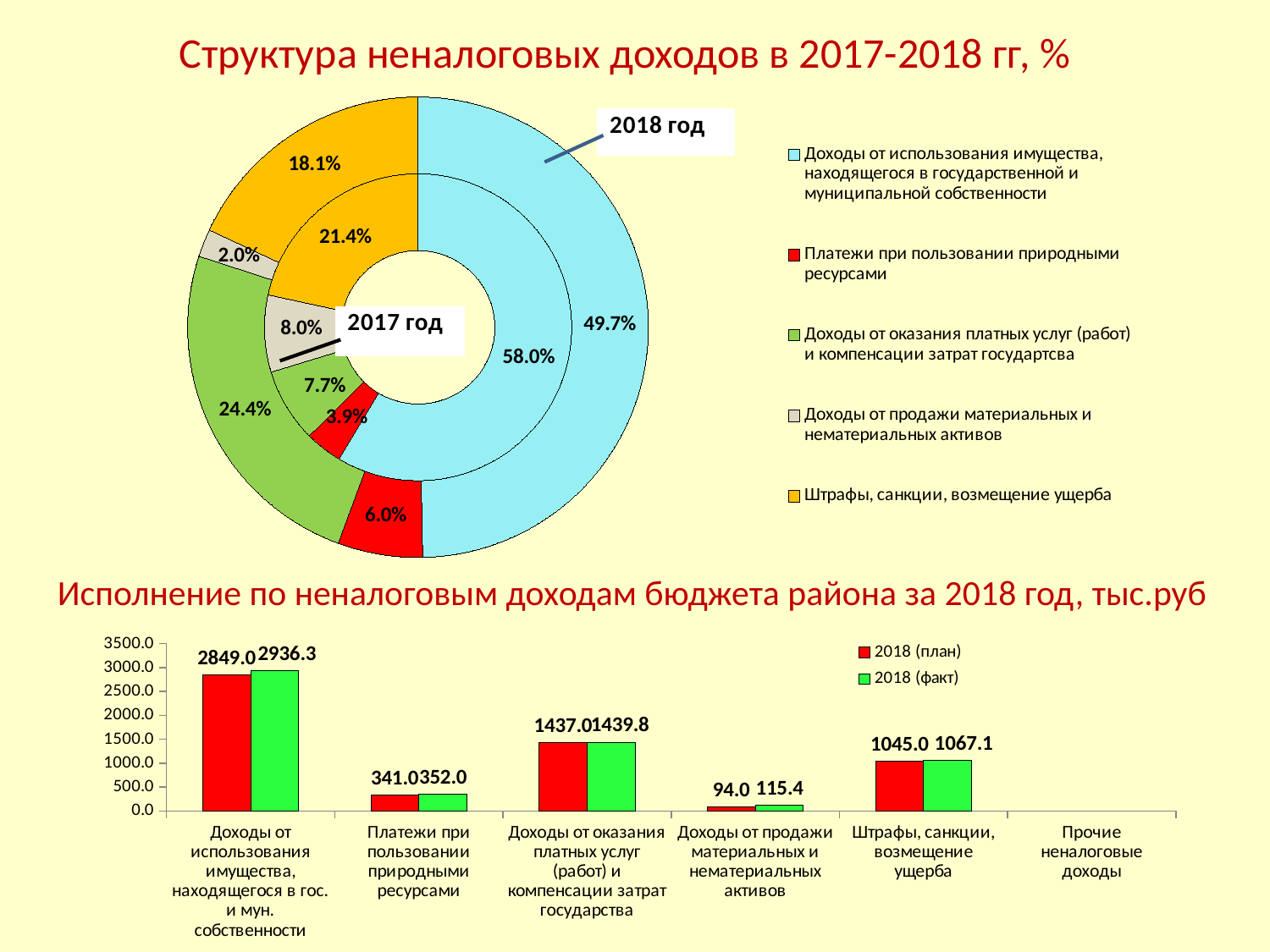
In the doughnut chart 'Структура неналоговых доходов в 2017-2018 гг, %', by how many percentage points did the share of 'Платежи при пользовании природными ресурсами' change from 2017 (3.9%) to 2018 (6.0%)? 2.1 percentage points In the bar chart 'Исполнение по неналоговым доходам бюджета района за 2018 год, тыс.руб', what is the 2018 (факт) value for 'Платежи при пользовании природными ресурсами'? 352.0 In the doughnut chart 'Структура неналоговых доходов в 2017-2018 гг, %', which category had the smallest share in 2018? Доходы от продажи материальных и нематериальных активов In the bar chart 'Исполнение по неналоговым доходам бюджета района за 2018 год, тыс.руб', which category has the highest 2018 (факт) value? Доходы от использования имущества, находящегося в гос. и мун. собственности How many categories does the legend of the doughnut chart 'Структура неналоговых доходов в 2017-2018 гг, %' list? 5 In the bar chart 'Исполнение по неналоговым доходам бюджета района за 2018 год, тыс.руб', what is the difference between the 2018 (факт) and 2018 (план) values for 'Доходы от использования имущества, находящегося в гос. и мун. собственности'? 87.3 In the doughnut chart 'Структура неналоговых доходов в 2017-2018 гг, %', what share did 'Доходы от использования имущества, находящегося в государственной и муниципальной собственности' have in 2018? 49.7% In the doughnut chart 'Структура неналоговых доходов в 2017-2018 гг, %', what share did 'Штрафы, санкции, возмещение ущерба' have in 2017? 21.4% What type of chart is the bottom chart 'Исполнение по неналоговым доходам бюджета района за 2018 год, тыс.руб'? Bar chart In the bar chart 'Исполнение по неналоговым доходам бюджета района за 2018 год, тыс.руб', is the 2018 (факт) value for 'Доходы от продажи материальных и нематериальных активов' greater or less than 500.0? less In the doughnut chart 'Структура неналоговых доходов в 2017-2018 гг, %', what share did 'Доходы от оказания платных услуг (работ) и компенсации затрат государтсва' have in 2018? 24.4% In the bar chart 'Исполнение по неналоговым доходам бюджета района за 2018 год, тыс.руб', what is the 2018 (план) value for 'Штрафы, санкции, возмещение ущерба'? 1045.0